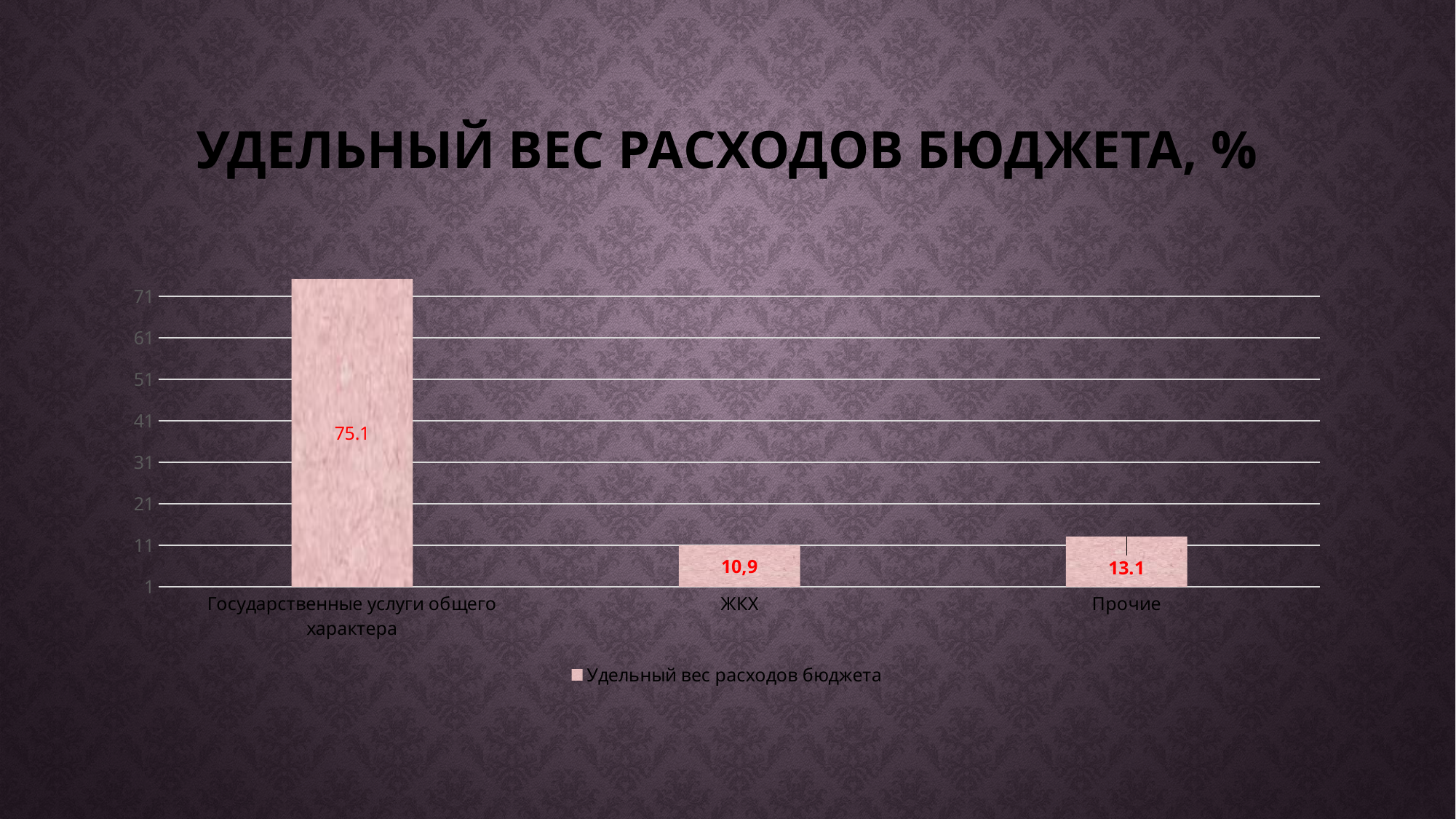
What is the value for Государственные услуги общего характера? 75.1 What kind of chart is shown on the slide? bar chart What is the value for Прочие? 13.1 Which category has the lowest value? ЖКХ What is the title of the chart? УДЕЛЬНЫЙ ВЕС РАСХОДОВ БЮДЖЕТА, % What is the value for ЖКХ? 10,9 What is the difference between the values for Прочие and ЖКХ? 2.2 What is the difference between the values for Государственные услуги общего характера and Прочие? 62 How many categories are shown on the chart? 3 Which category has the highest value? Государственные услуги общего характера Is the value for Государственные услуги общего характера greater or less than 71? greater Which is larger, the value for Прочие or the value for ЖКХ? Прочие